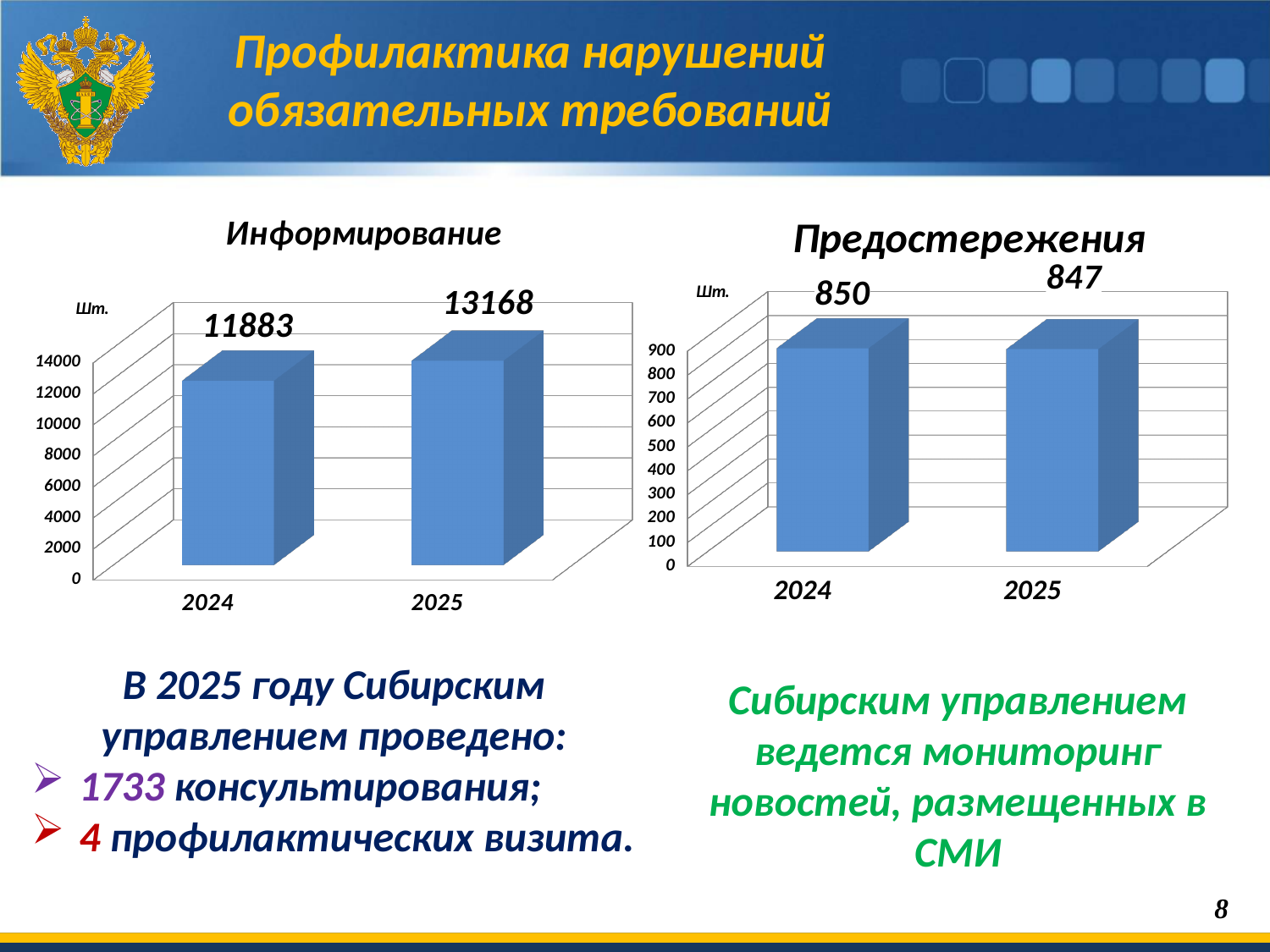
In the 'Предостережения' chart, what is the value for 2024? 850 In the 'Предостережения' chart, what is the value for 2025? 847 In the 'Информирование' chart, which year has the higher value? 2025 In the 'Предостережения' chart, do the values rise or fall from 2024 to 2025? fall In the 'Информирование' chart, what is the value for 2025? 13168 How many categories are shown in the 'Предостережения' chart? 2 In the 'Предостережения' chart, what is the difference between the 2024 and 2025 values? 3 In the 'Информирование' chart, what is the value for 2024? 11883 What kind of chart is the 'Информирование' chart? bar chart In the 'Информирование' chart, what is the difference between the 2025 and 2024 values? 1285 In the 'Информирование' chart, do the values rise or fall from 2024 to 2025? rise What unit label is shown on the vertical axis of the 'Предостережения' chart? Шт.